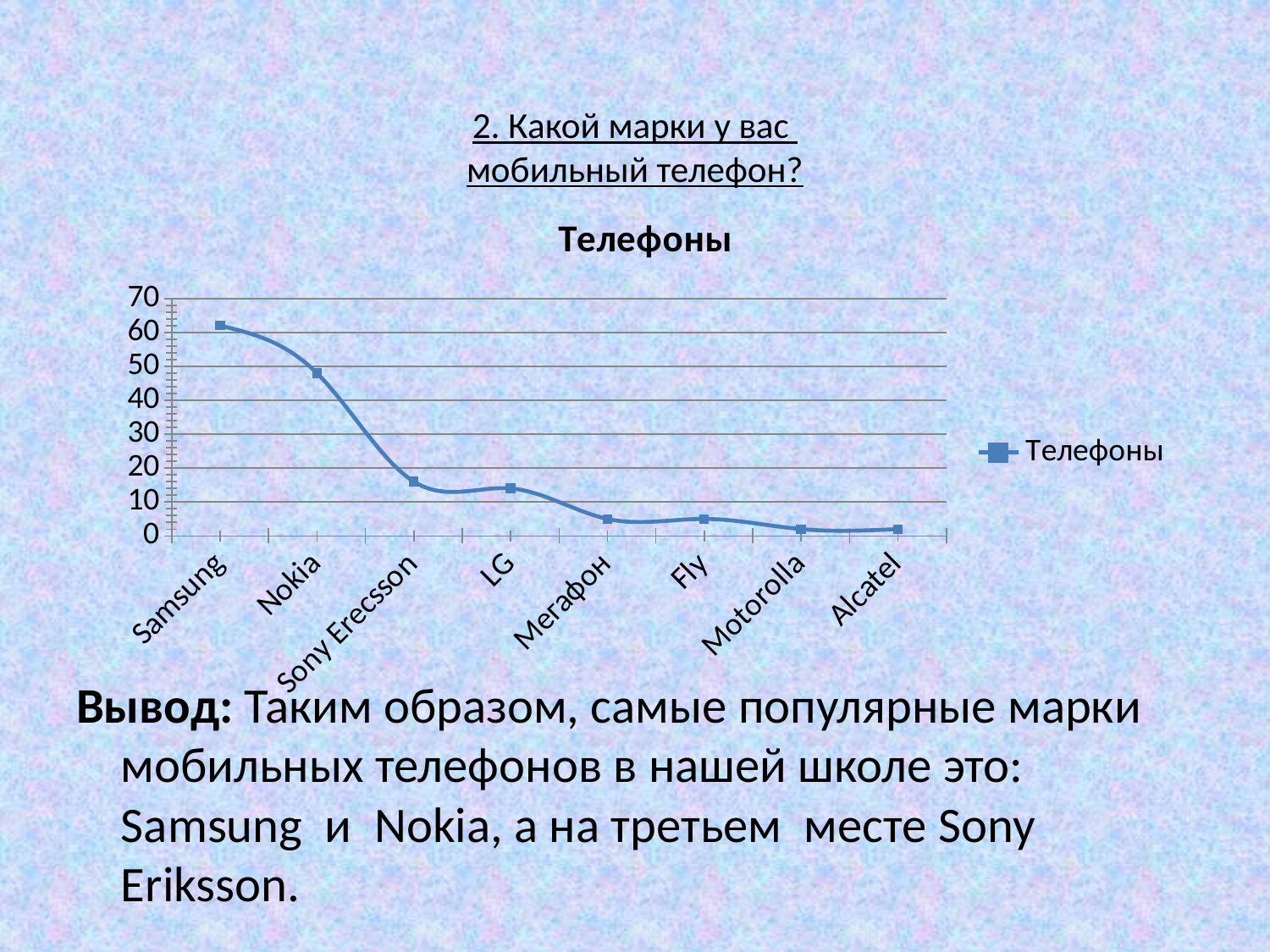
Do the values generally rise or fall from Samsung to Alcatel along the x axis? fall What is the title of the chart? Телефоны Is the value for Nokia greater or less than 40? greater How many series does the legend list? 1 Is the value for Samsung greater or less than 50? greater Is the value for Мегафон greater or less than 10? less What kind of chart is shown on the slide? line chart Which is larger, the value for Samsung or the value for Nokia? Samsung How many phone brands (categories) are plotted on the x axis? 8 Which brand has the highest value? Samsung Which is larger, the value for Nokia or the value for Sony Erecsson? Nokia